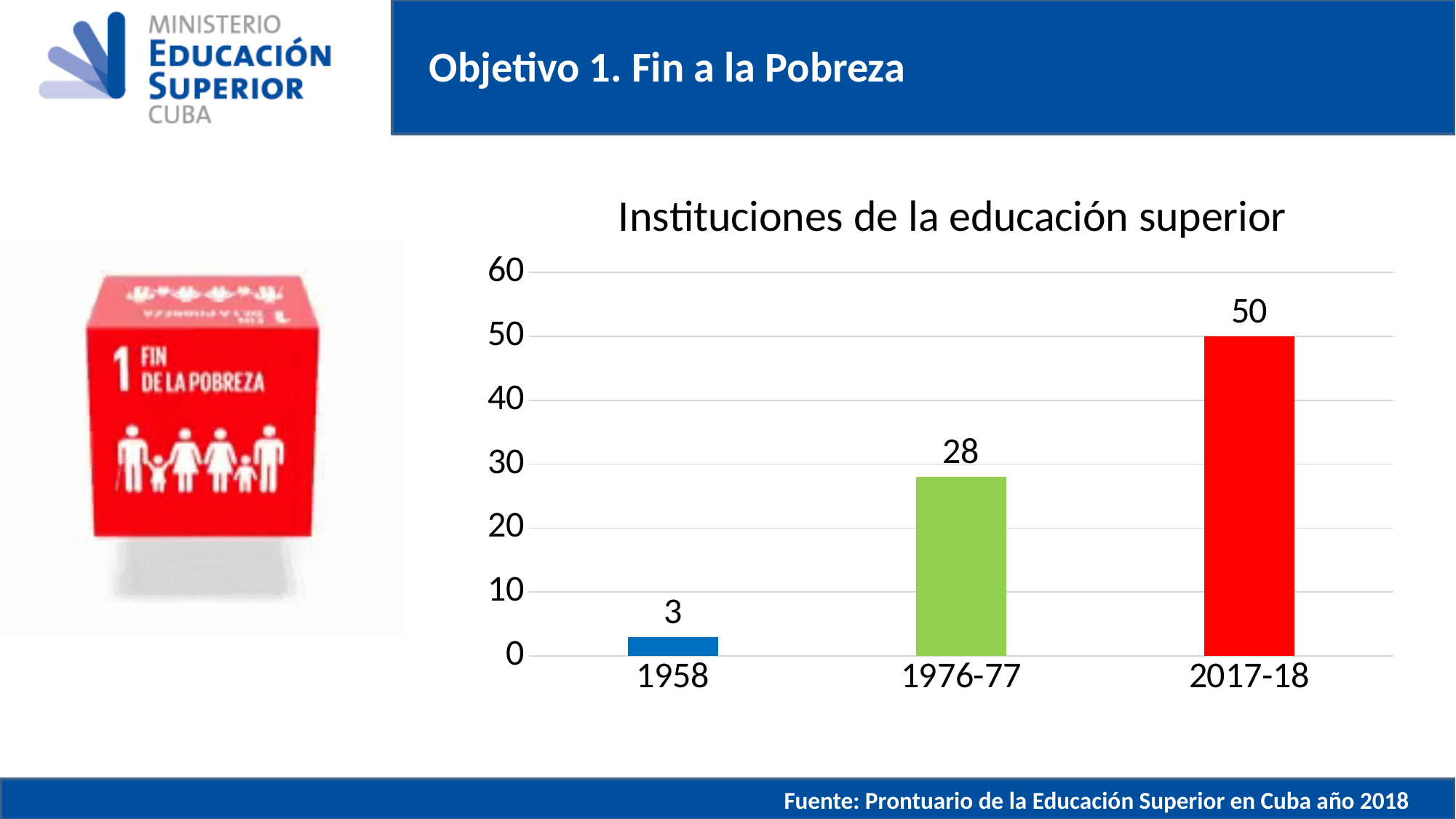
Is the value for 2017-18 greater or less than 40? greater How many categories are shown on the x axis? 3 What kind of chart is shown on the slide? bar chart What is the value for 2017-18? 50 What is the title of the chart? Instituciones de la educación superior What is the difference between the values for 2017-18 and 1976-77? 22 Which category has the lowest value? 1958 What is the value for 1958? 3 What is the difference between the values for 1976-77 and 1958? 25 Which is larger, the value for 1958 or the value for 1976-77? 1976-77 Which category has the highest value? 2017-18 What is the value for 1976-77? 28